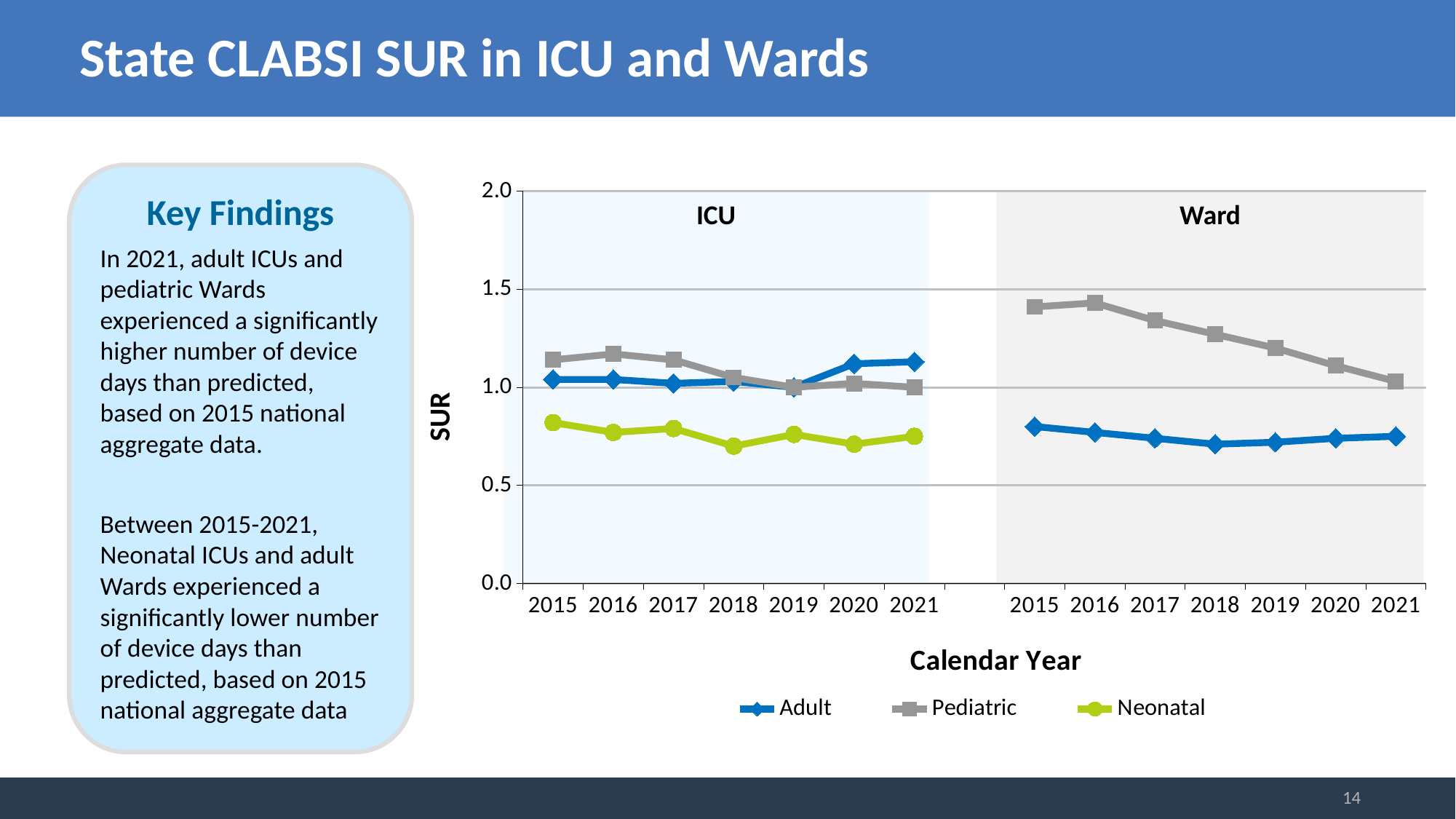
Which series appears only in the ICU panel and not in the Ward panel? Neonatal In the Ward panel, is the Pediatric SUR for 2016 greater or less than 1.5? less In the Ward panel, does the Pediatric SUR rise or fall from 2016 to 2021? fall In the Ward panel, which year has the lowest Pediatric SUR? 2021 How many calendar years are plotted in the ICU panel? 7 In the ICU panel, which series has the lowest SUR in 2021? Neonatal What is the title of the x axis? Calendar Year How many series does the legend list? 3 In the Ward panel for 2015, which series has the larger SUR, Adult or Pediatric? Pediatric In the ICU panel, is the Neonatal SUR for 2018 greater or less than 1.0? less In the Ward panel, is the Adult SUR for 2018 greater or less than 0.5? greater What kind of chart is shown on the slide? line chart